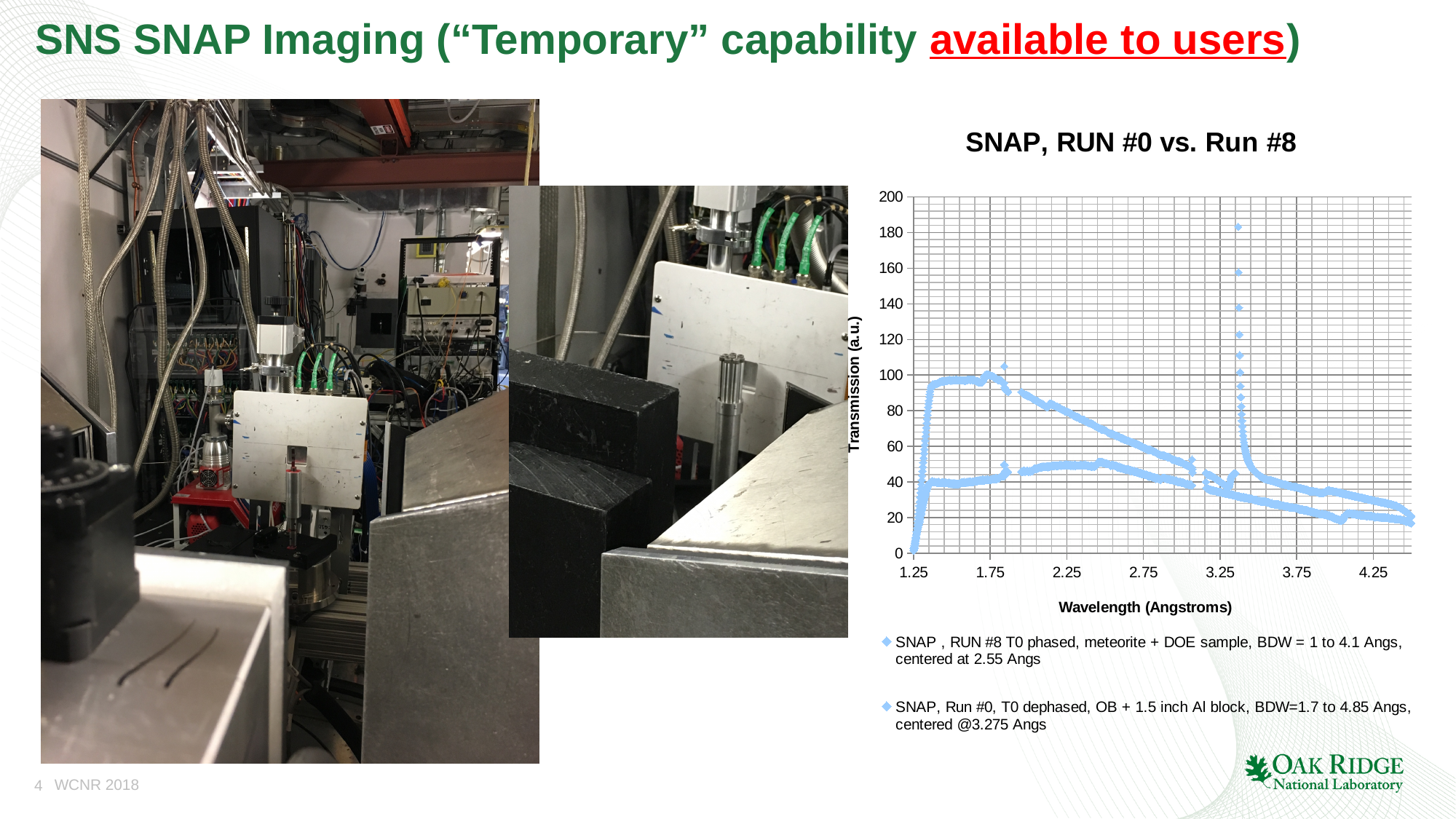
Is the highest plotted transmission value on the chart greater or less than 160? greater At a wavelength of 2.25 Angstroms, is the lower curve's transmission value greater or less than 60? less What is the label of the chart's x axis? Wavelength (Angstroms) Between 2.25 and 3.0 Angstroms, does the upper curve's transmission rise or fall as wavelength increases? fall Is the highest plotted transmission value on the chart greater or less than 200? less What is the title of the chart? SNAP, RUN #0 vs. Run #8 What kind of chart is shown on the slide? scatter chart How many series does the chart's legend list? 2 Between 3.75 and 4.25 Angstroms, does the plotted transmission rise or fall as wavelength increases? fall